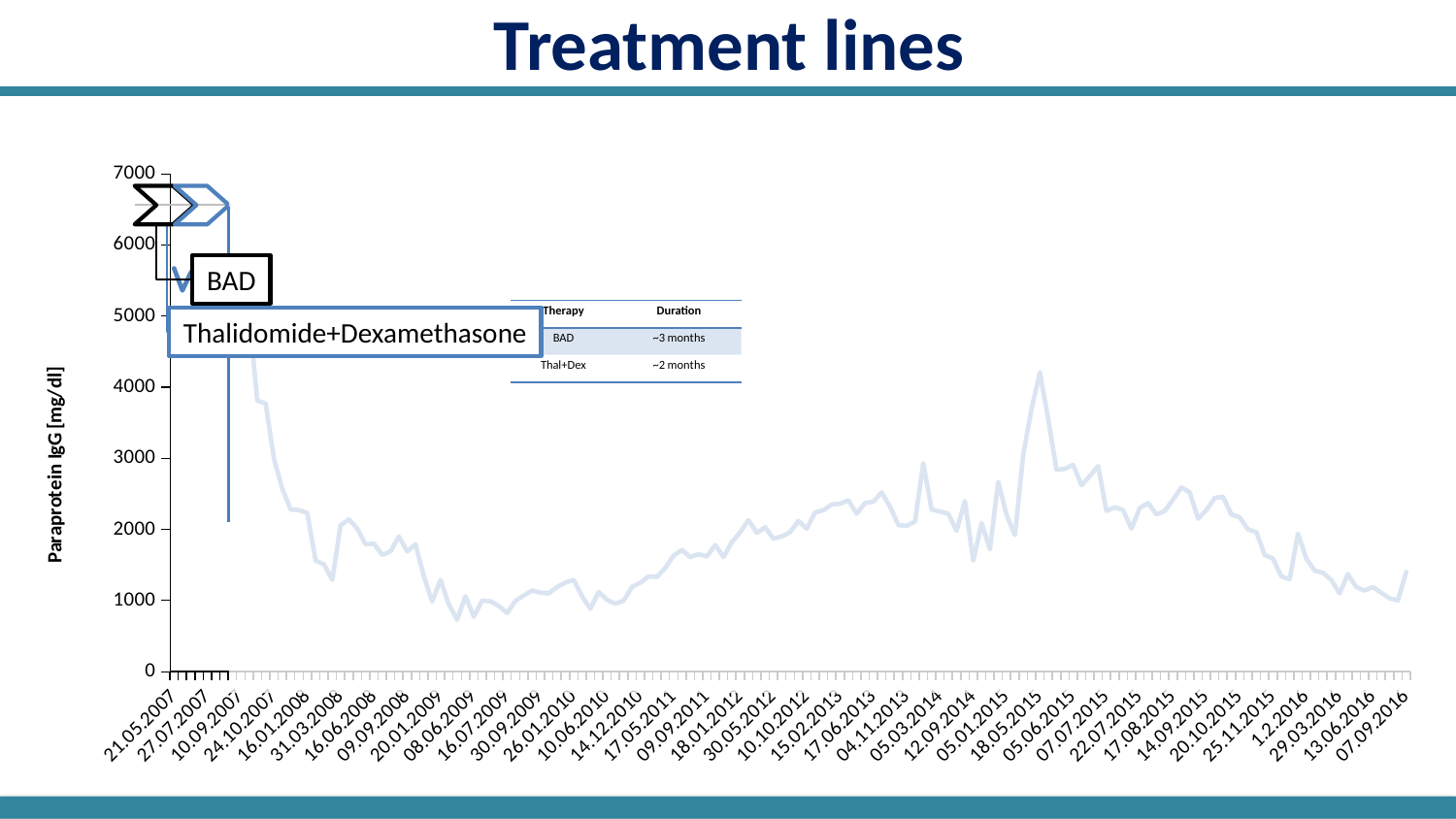
Is the value for 07.09.2016 greater or less than 1000? greater Is the value for 09.09.2008 greater or less than 2000? less What kind of chart is shown on the slide? line chart According to the table on the chart, what is the duration of the BAD therapy? ~3 months Is the value for 18.05.2015 greater or less than 3000? greater What is the label of the y axis of the chart? Paraprotein IgG [mg/dl] What is the highest tick value shown on the y axis? 7000 What is the last date shown on the x axis? 07.09.2016 Overall, do the values rise or fall from 2007 to 2016? fall What is the first date shown on the x axis? 21.05.2007